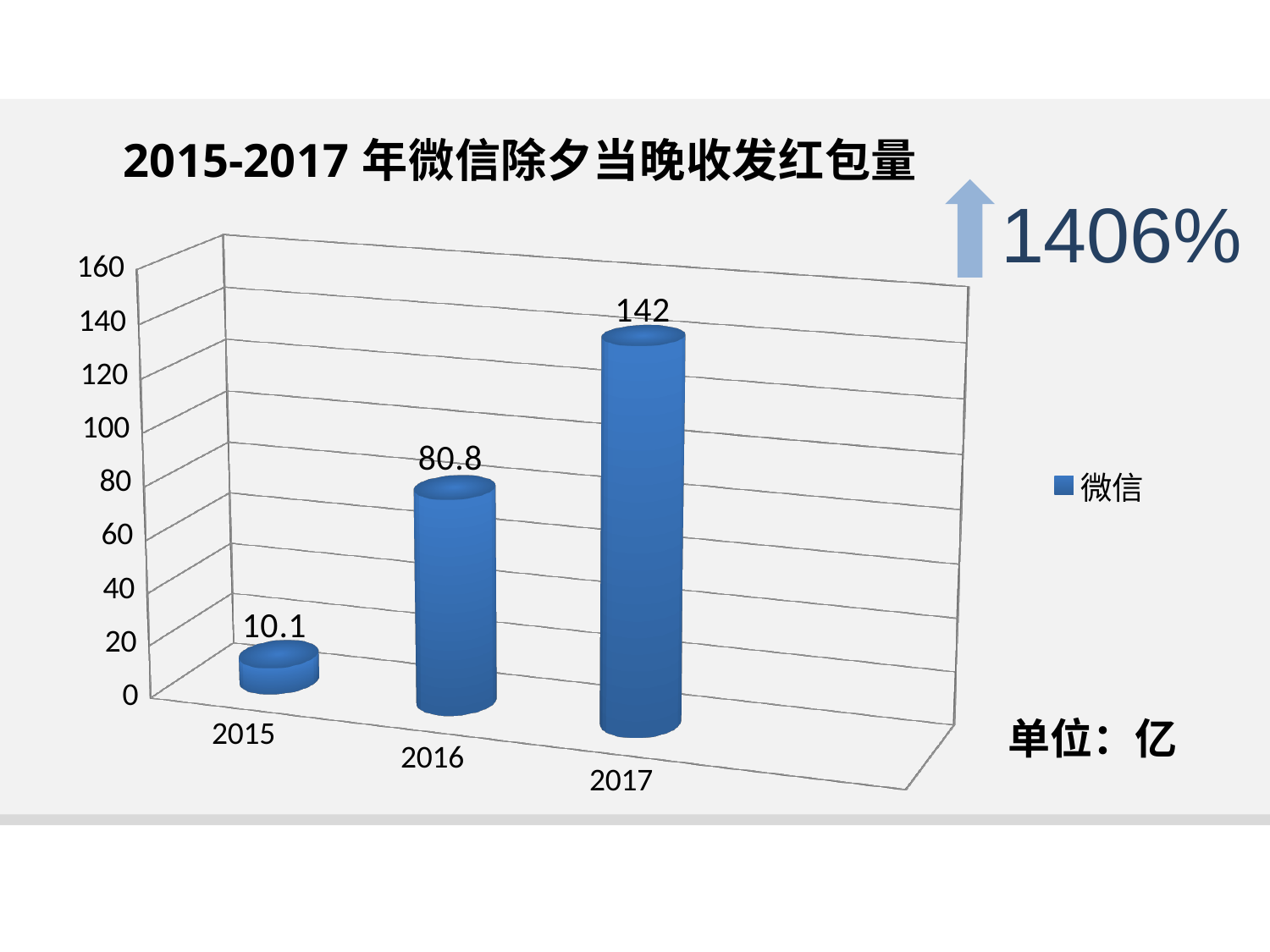
What kind of chart is shown? bar chart How many series does the legend list? 1 Which year has the highest value? 2017 What is the difference between the values for 2017 and 2016? 61.2 What is the value for 2015? 10.1 Which year has the lowest value? 2015 What is the difference between the values for 2016 and 2015? 70.7 How many years are shown on the x axis? 3 What is the value for 2016? 80.8 Which is larger, the value for 2016 or the value for 2015? 2016 What is the value for 2017? 142 Do the values rise or fall from 2015 to 2017? rise